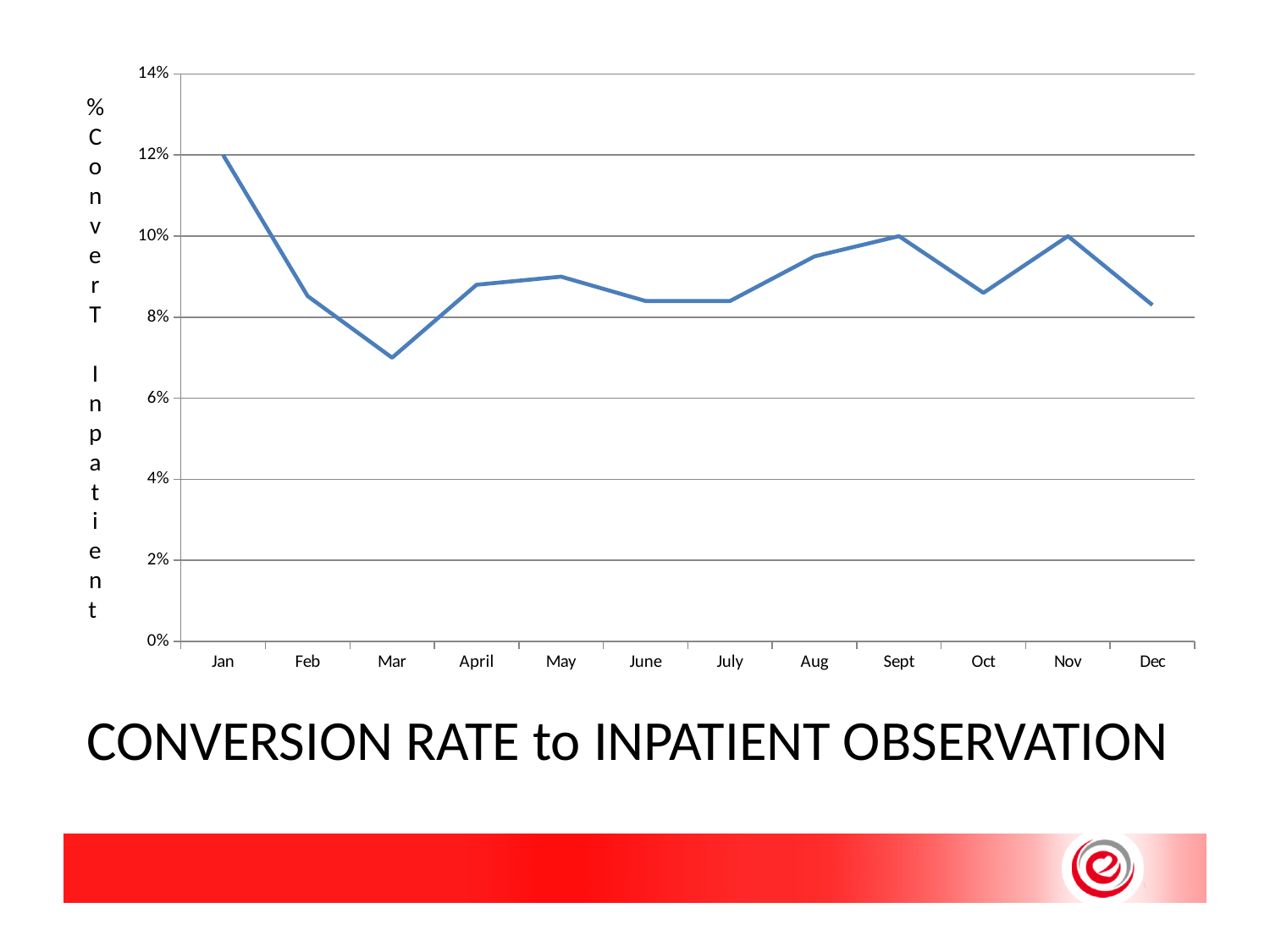
How many months are plotted on the x axis? 12 Which month has the lowest conversion rate? Mar Is the value for Mar greater or less than 8%? less Does the conversion rate rise or fall from Jan to Mar? fall Is the value for Aug greater or less than 8%? greater What is the conversion rate for Nov? 10% What is the conversion rate for Jan? 12% What is the conversion rate for Sept? 10% What kind of chart is shown on the slide? line chart What is the title of the chart? CONVERSION RATE to INPATIENT OBSERVATION Which is larger, the value for Jan or the value for Dec? Jan Which month has the highest conversion rate? Jan